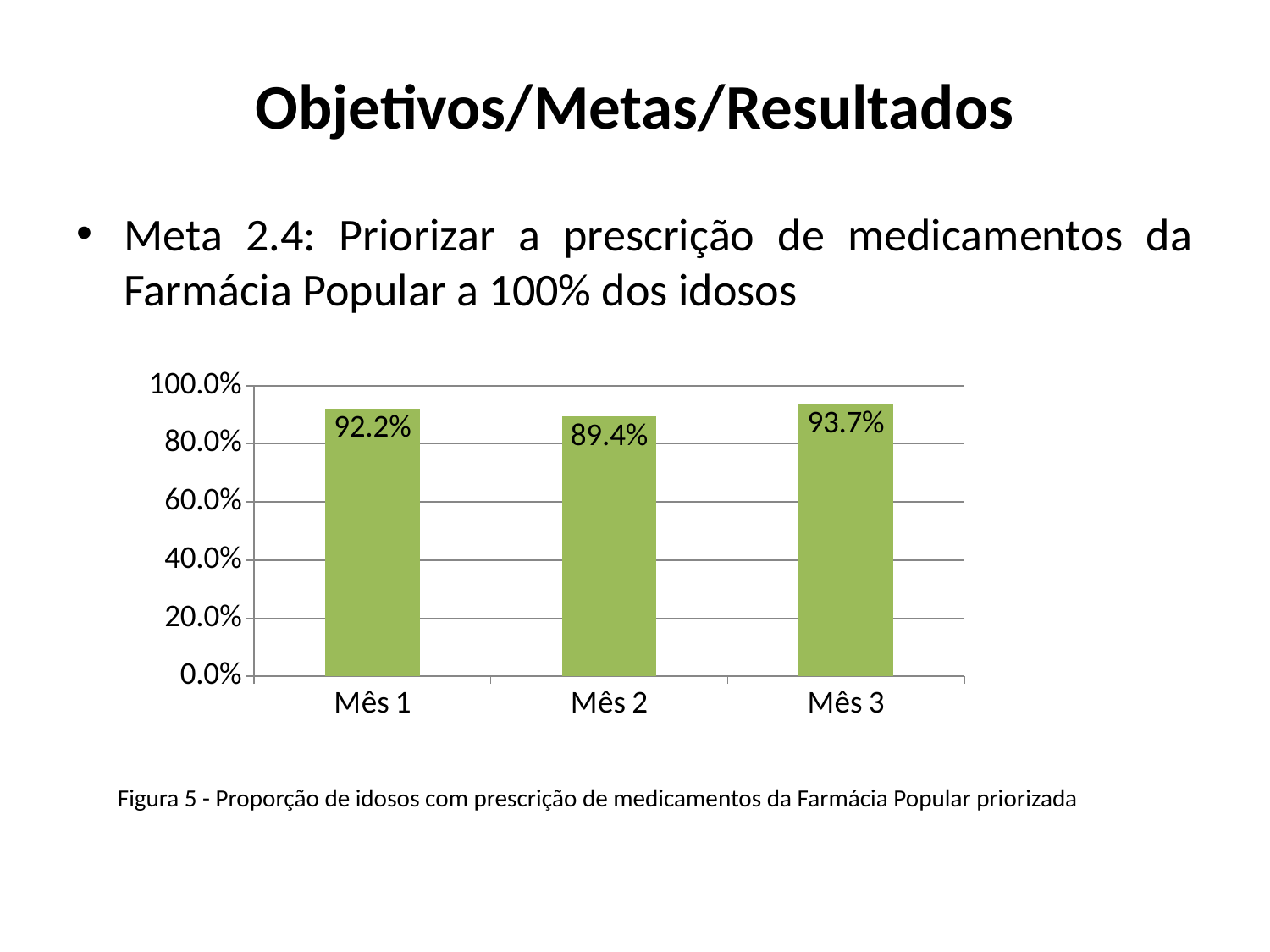
What is the difference between the values for Mês 1 and Mês 2? 2.8% How many categories are shown on the x axis? 3 What is the value for Mês 1? 92.2% What kind of chart is shown on the slide? bar chart Which is larger, the value for Mês 1 or the value for Mês 2? Mês 1 What is the value for Mês 2? 89.4% Which month has the highest value? Mês 3 Which month has the lowest value? Mês 2 Is the value for Mês 2 greater or less than 80.0%? greater What is the value for Mês 3? 93.7% What is the caption of the figure below the chart? Figura 5 - Proporção de idosos com prescrição de medicamentos da Farmácia Popular priorizada What is the difference between the values for Mês 3 and Mês 2? 4.3%